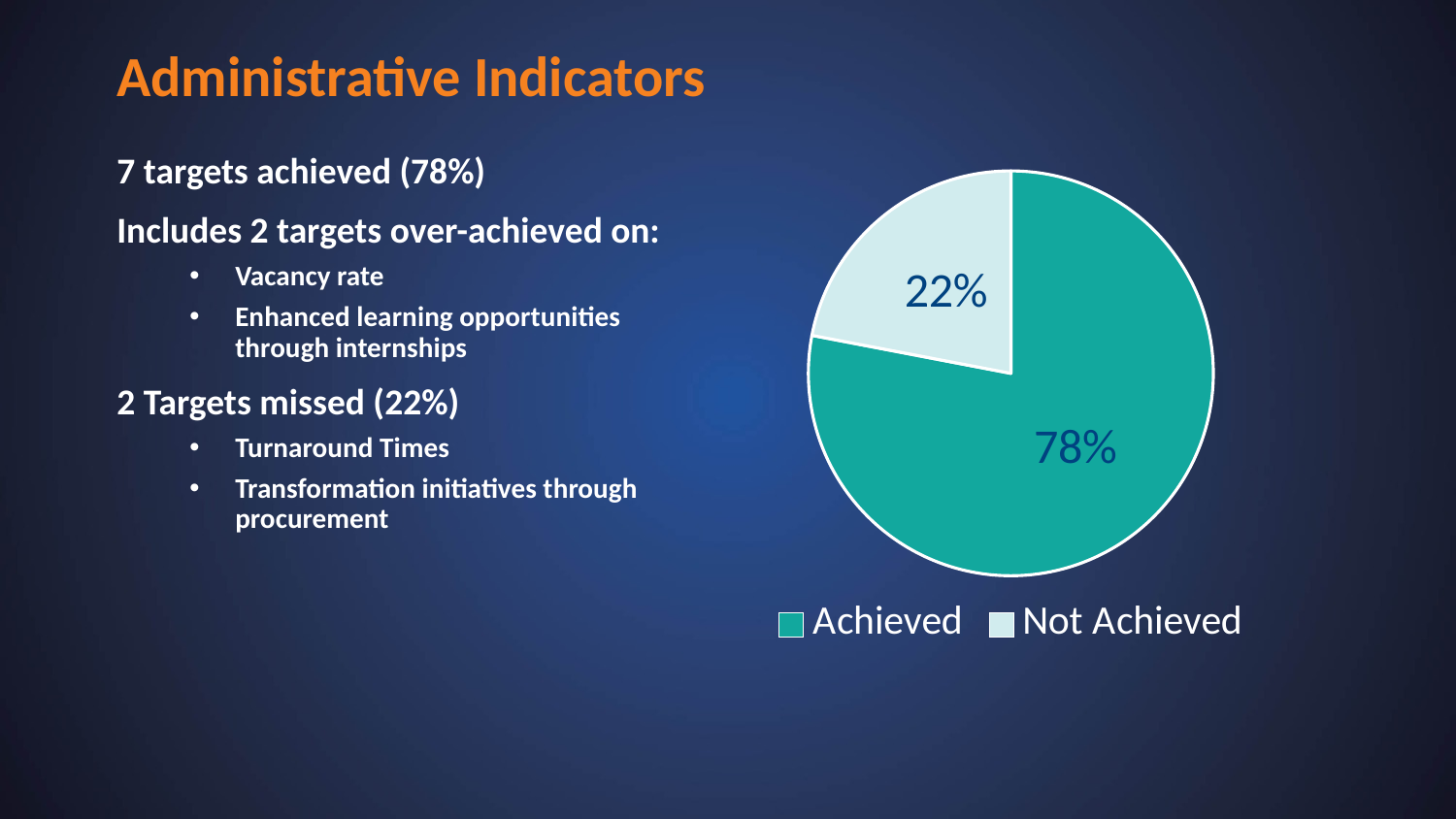
What is the total of the two slice percentages shown on the pie? 100% How many slices does the pie chart have? 2 Which is larger, the Achieved slice or the Not Achieved slice? Achieved What kind of chart is shown on the slide? pie chart How many entries does the legend list? 2 What colour is the Achieved slice of the pie? teal What are the two legend entries of the pie chart? Achieved, Not Achieved Which slice of the pie is the smallest? Not Achieved What is the difference in percentage points between the Achieved and Not Achieved slices? 56 What share of the pie is labelled Achieved? 78% What share of the pie is labelled Not Achieved? 22% Which slice of the pie is the largest? Achieved